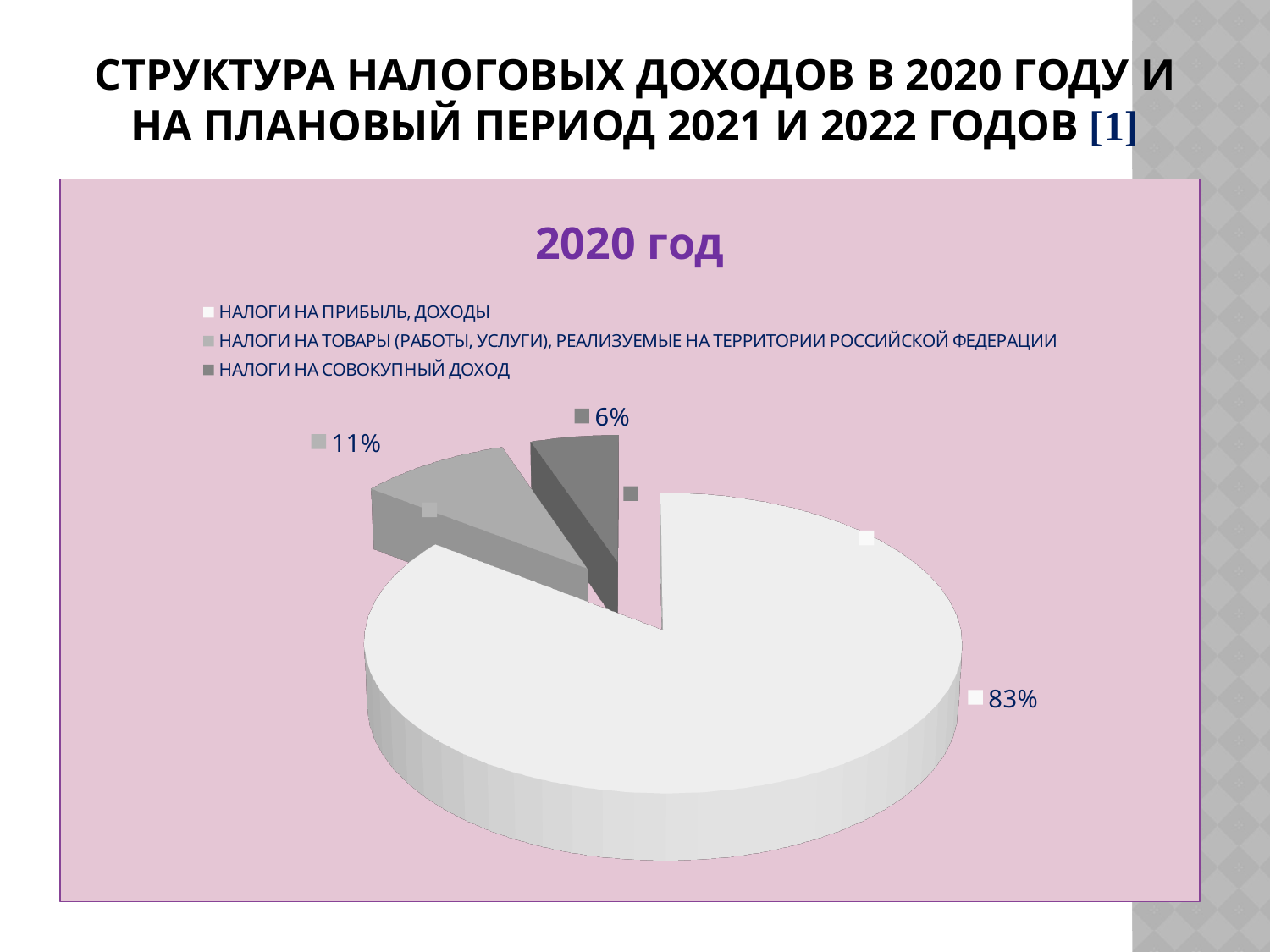
How many slices does the pie chart have? 3 What type of chart is shown on the slide? Pie chart What is the difference in percentage points between the share of НАЛОГИ НА ПРИБЫЛЬ, ДОХОДЫ and the share of НАЛОГИ НА ТОВАРЫ (РАБОТЫ, УСЛУГИ), РЕАЛИЗУЕМЫЕ НА ТЕРРИТОРИИ РОССИЙСКОЙ ФЕДЕРАЦИИ? 72% Which legend entry is shown in the darkest grey colour? НАЛОГИ НА СОВОКУПНЫЙ ДОХОД What is the title of the chart? 2020 год How many entries does the chart legend list? 3 What share of the pie is НАЛОГИ НА СОВОКУПНЫЙ ДОХОД? 6% What share of the pie is НАЛОГИ НА ТОВАРЫ (РАБОТЫ, УСЛУГИ), РЕАЛИЗУЕМЫЕ НА ТЕРРИТОРИИ РОССИЙСКОЙ ФЕДЕРАЦИИ? 11% What share of the pie is НАЛОГИ НА ПРИБЫЛЬ, ДОХОДЫ? 83% Which is larger: the share of НАЛОГИ НА ТОВАРЫ (РАБОТЫ, УСЛУГИ), РЕАЛИЗУЕМЫЕ НА ТЕРРИТОРИИ РОССИЙСКОЙ ФЕДЕРАЦИИ or the share of НАЛОГИ НА СОВОКУПНЫЙ ДОХОД? НАЛОГИ НА ТОВАРЫ (РАБОТЫ, УСЛУГИ), РЕАЛИЗУЕМЫЕ НА ТЕРРИТОРИИ РОССИЙСКОЙ ФЕДЕРАЦИИ Which category has the largest share of the pie? НАЛОГИ НА ПРИБЫЛЬ, ДОХОДЫ Which category has the smallest share of the pie? НАЛОГИ НА СОВОКУПНЫЙ ДОХОД